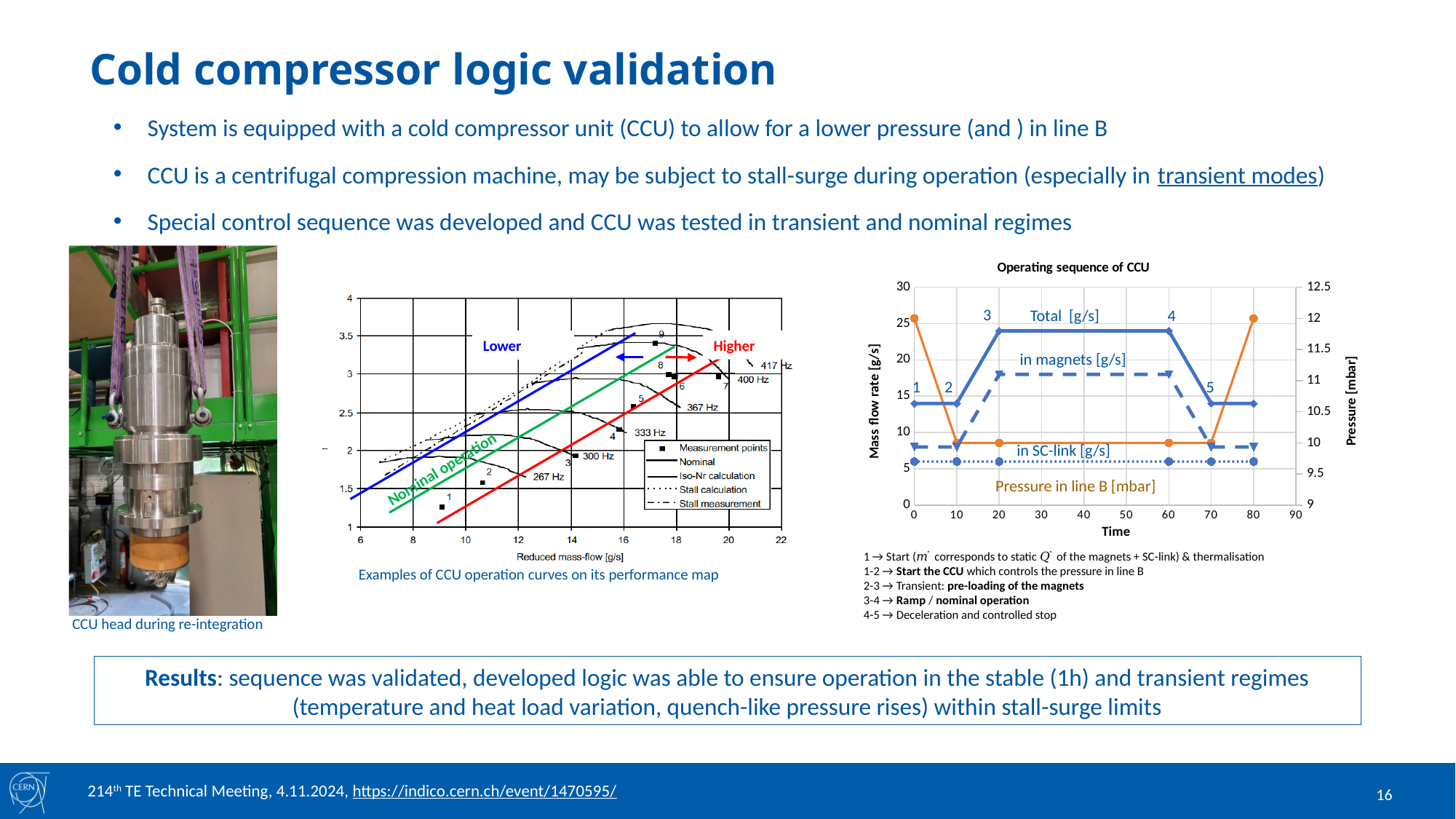
In the 'Operating sequence of CCU' chart, does 'Pressure in line B [mbar]' rise or fall between time 0 and time 10? fall In the 'Operating sequence of CCU' chart, is the value of 'in SC-link [g/s]' at time 0 greater or less than 10? less In the 'Operating sequence of CCU' chart, how many data series are plotted? 4 What kind of chart is the 'Operating sequence of CCU' chart? line chart In the 'Operating sequence of CCU' chart, is the value of 'Total [g/s]' at time 40 greater or less than 20? greater In the 'Operating sequence of CCU' chart, what is the label of the left vertical axis? Mass flow rate [g/s] In the 'Operating sequence of CCU' chart, is 'Pressure in line B [mbar]' at time 40 greater or less than 11 mbar? less In the 'Operating sequence of CCU' chart, how many numbered sequence points (1 to 5) are marked on the Total curve? 5 In the 'Operating sequence of CCU' chart, what is the label of the right vertical axis? Pressure [mbar] In the 'Operating sequence of CCU' chart, which is larger at time 40: 'Total [g/s]' or 'in magnets [g/s]'? Total [g/s] In the CCU performance map chart, how many numbered measurement points are shown? 9